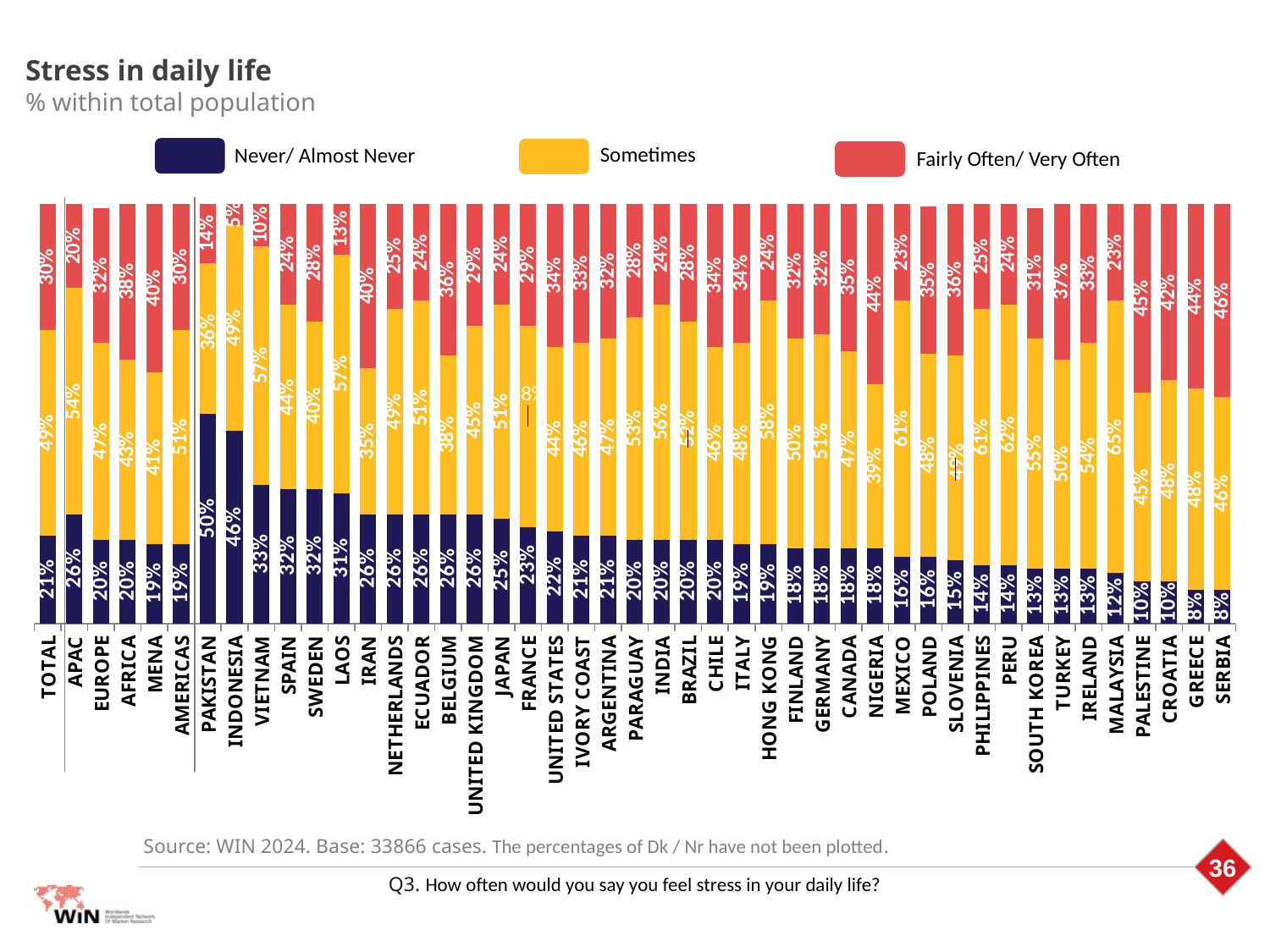
What is the 'Never/ Almost Never' value for Pakistan? 50% Which has a larger 'Sometimes' value, Peru or Iran? Peru What is the difference between the 'Never/ Almost Never' values for Vietnam and Serbia? 25% What kind of chart is shown on the slide? Stacked bar chart Which country has the lowest 'Fairly Often/ Very Often' value? Indonesia How many series does the legend list? 3 Which country has the highest 'Never/ Almost Never' value? Pakistan What is the 'Fairly Often/ Very Often' value for Nigeria? 44% What is the subtitle shown under the chart title? % within total population What is the difference between the 'Fairly Often/ Very Often' values for MENA and APAC? 20% What is the 'Never/ Almost Never' value for TOTAL? 21% What is the 'Sometimes' value for Malaysia? 65%